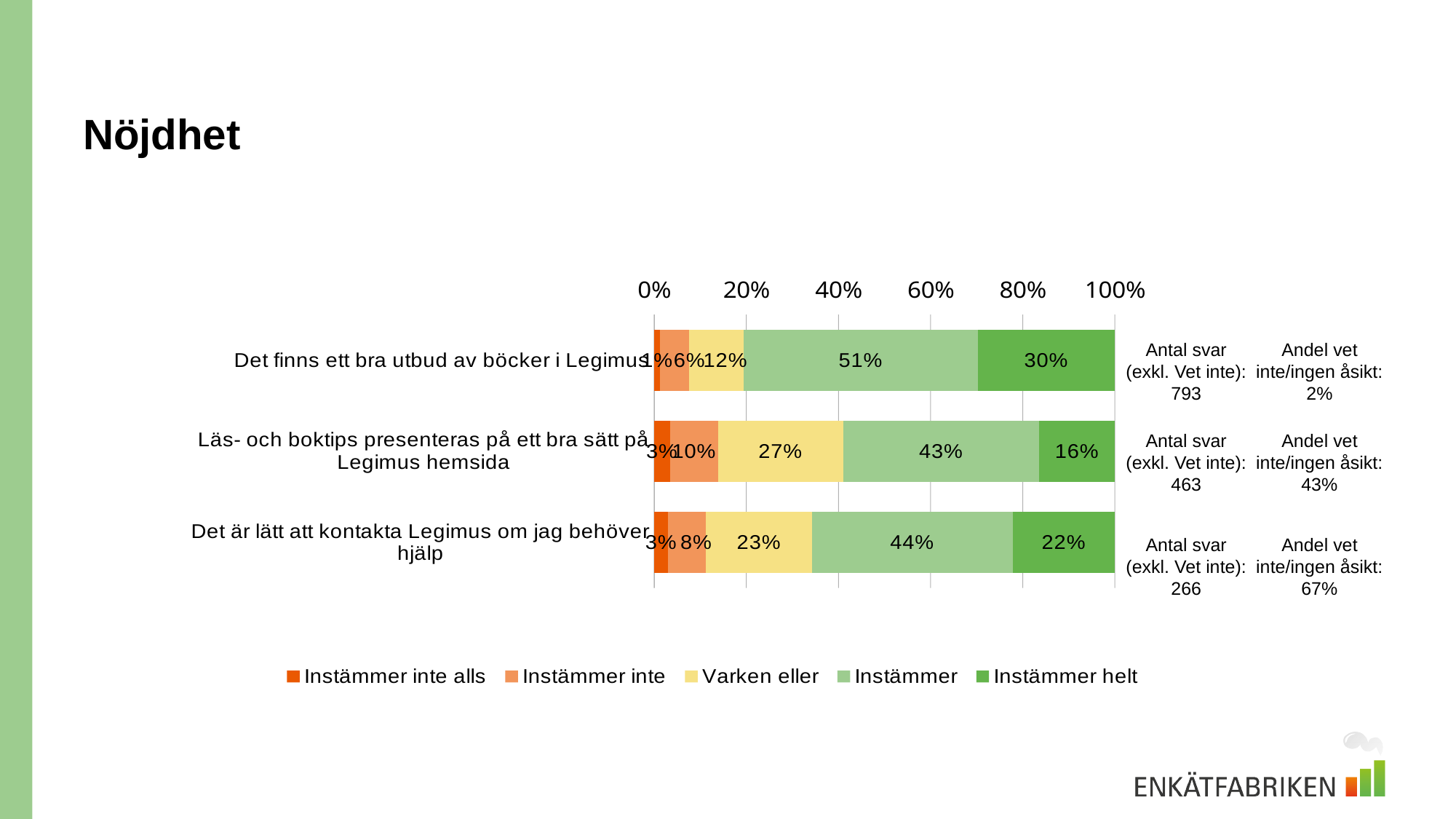
What kind of chart is shown on the slide? Stacked bar chart What is the 'Varken eller' value for 'Läs- och boktips presenteras på ett bra sätt på Legimus hemsida'? 27% What is the title of the slide? Nöjdhet Which statement has the highest 'Instämmer helt' share? Det finns ett bra utbud av böcker i Legimus How many series does the legend list? 5 What is the difference between the 'Instämmer' values for 'Det finns ett bra utbud av böcker i Legimus' and 'Läs- och boktips presenteras på ett bra sätt på Legimus hemsida'? 8% Which statement has the lowest 'Instämmer helt' share? Läs- och boktips presenteras på ett bra sätt på Legimus hemsida What is the number of responses (Antal svar, exkl. Vet inte) shown for 'Det är lätt att kontakta Legimus om jag behöver hjälp'? 266 Which is larger: the 'Instämmer inte' value for 'Läs- och boktips presenteras på ett bra sätt på Legimus hemsida' or for 'Det är lätt att kontakta Legimus om jag behöver hjälp'? Läs- och boktips presenteras på ett bra sätt på Legimus hemsida What is the 'Instämmer' value for 'Det är lätt att kontakta Legimus om jag behöver hjälp'? 44% What is the 'Instämmer helt' value for 'Det finns ett bra utbud av böcker i Legimus'? 30% How many statements (categories) are plotted in the chart? 3